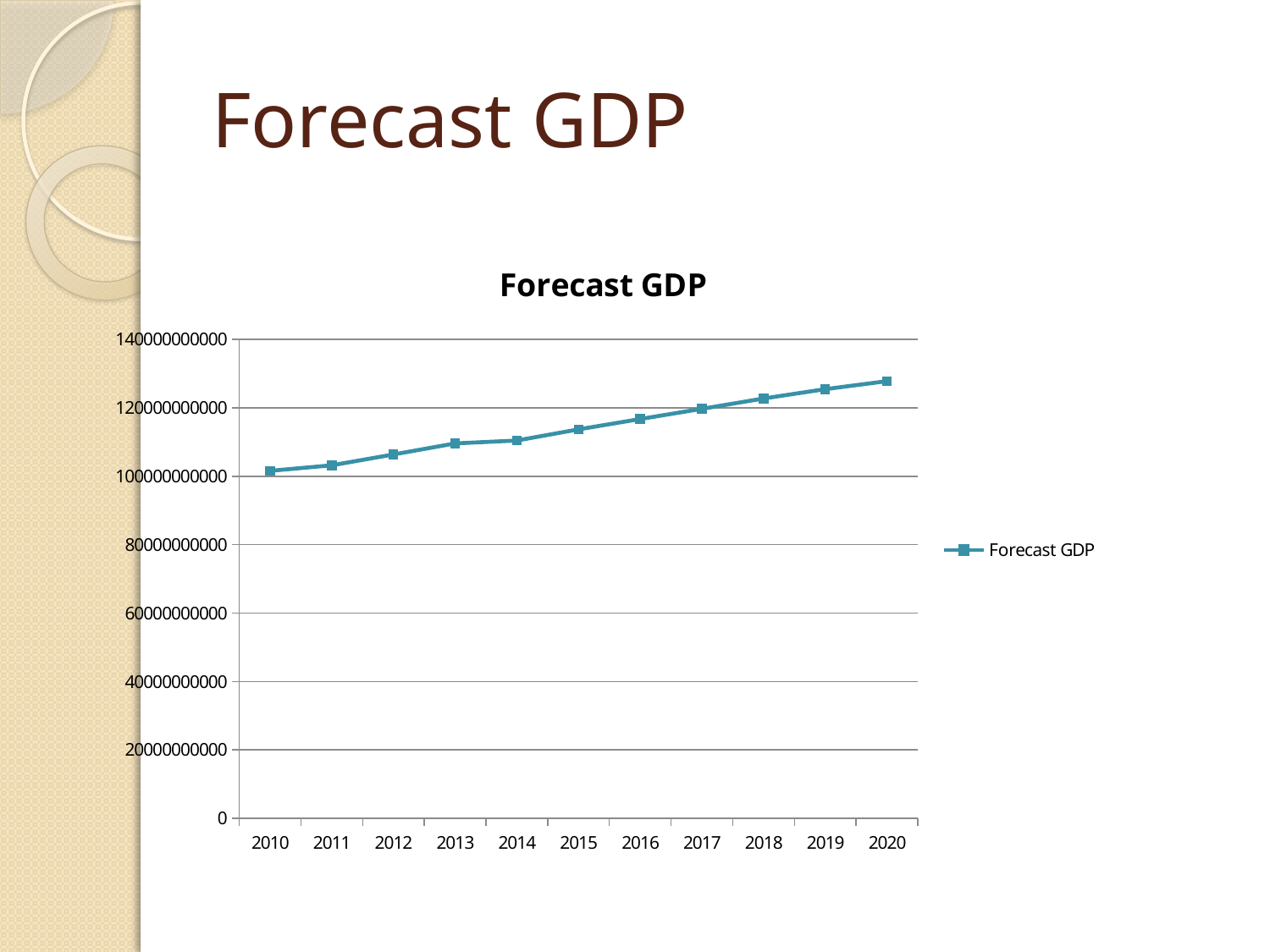
What kind of chart is shown on the slide? line chart What is the name of the series shown in the legend? Forecast GDP Which year has the larger Forecast GDP value, 2012 or 2018? 2018 Which year has the highest Forecast GDP value? 2020 How many years are plotted on the x axis? 11 What is the title of the chart? Forecast GDP How many series does the legend list? 1 Is the Forecast GDP value for 2014 greater or less than 120000000000? less Do the Forecast GDP values rise or fall from 2010 to 2020? rise Which year has the lowest Forecast GDP value? 2010 Is the Forecast GDP value for 2018 greater or less than 120000000000? greater Is the Forecast GDP value for 2020 greater or less than 140000000000? less